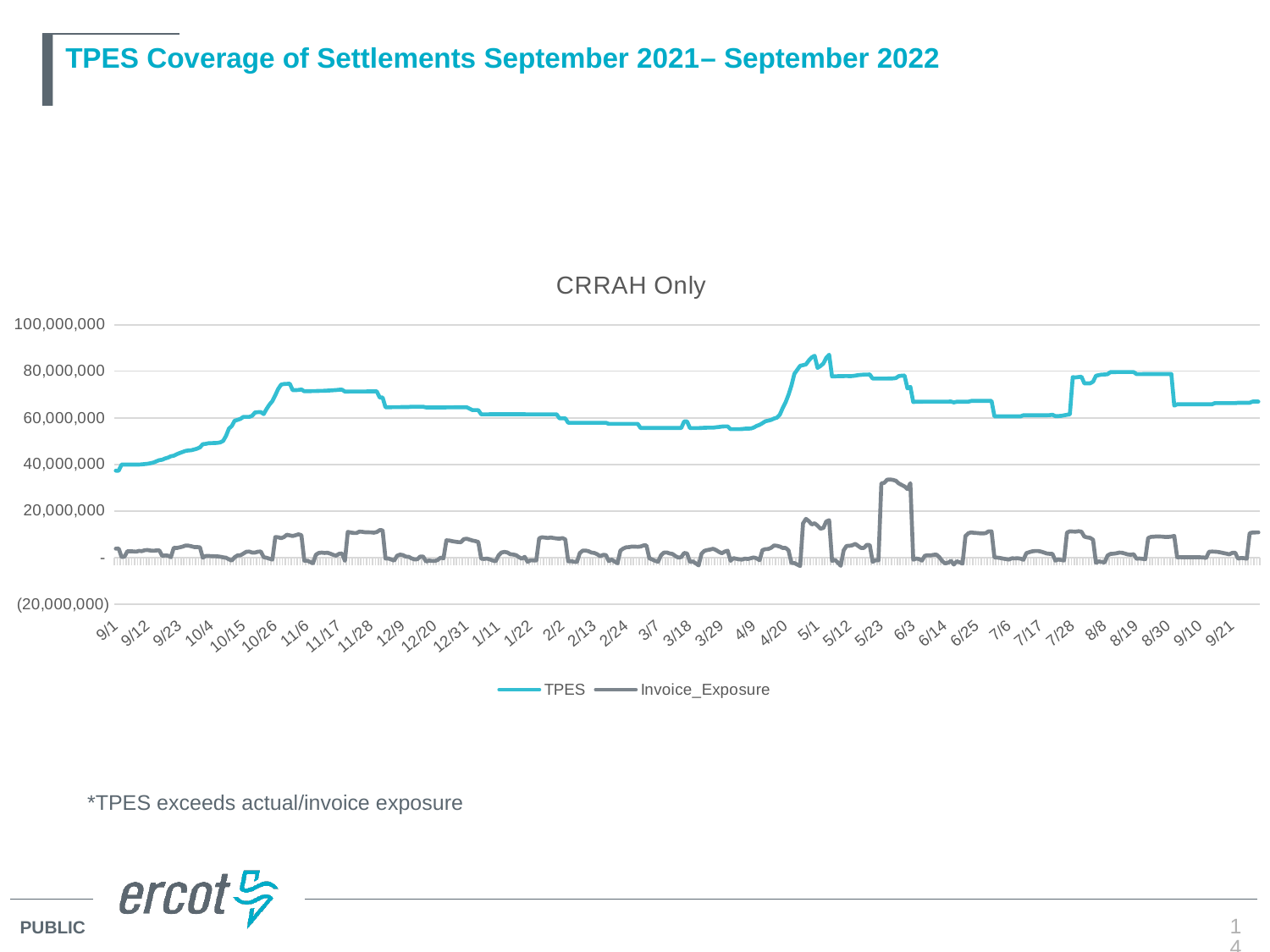
Which series stays higher across the whole period, TPES or Invoice_Exposure? TPES Is the TPES value at 9/1 greater or less than 60,000,000? less How many series does the legend list? 2 Is the TPES value at 11/6 greater or less than 60,000,000? greater At 5/23, which series has the higher value, TPES or Invoice_Exposure? TPES What kind of chart is shown on the slide? line chart Is the Invoice_Exposure value at 5/23 greater or less than 20,000,000? greater Does the TPES line rise or fall between 9/1 and 10/26? rise What are the two series named in the legend? TPES and Invoice_Exposure What is the title of the chart? CRRAH Only